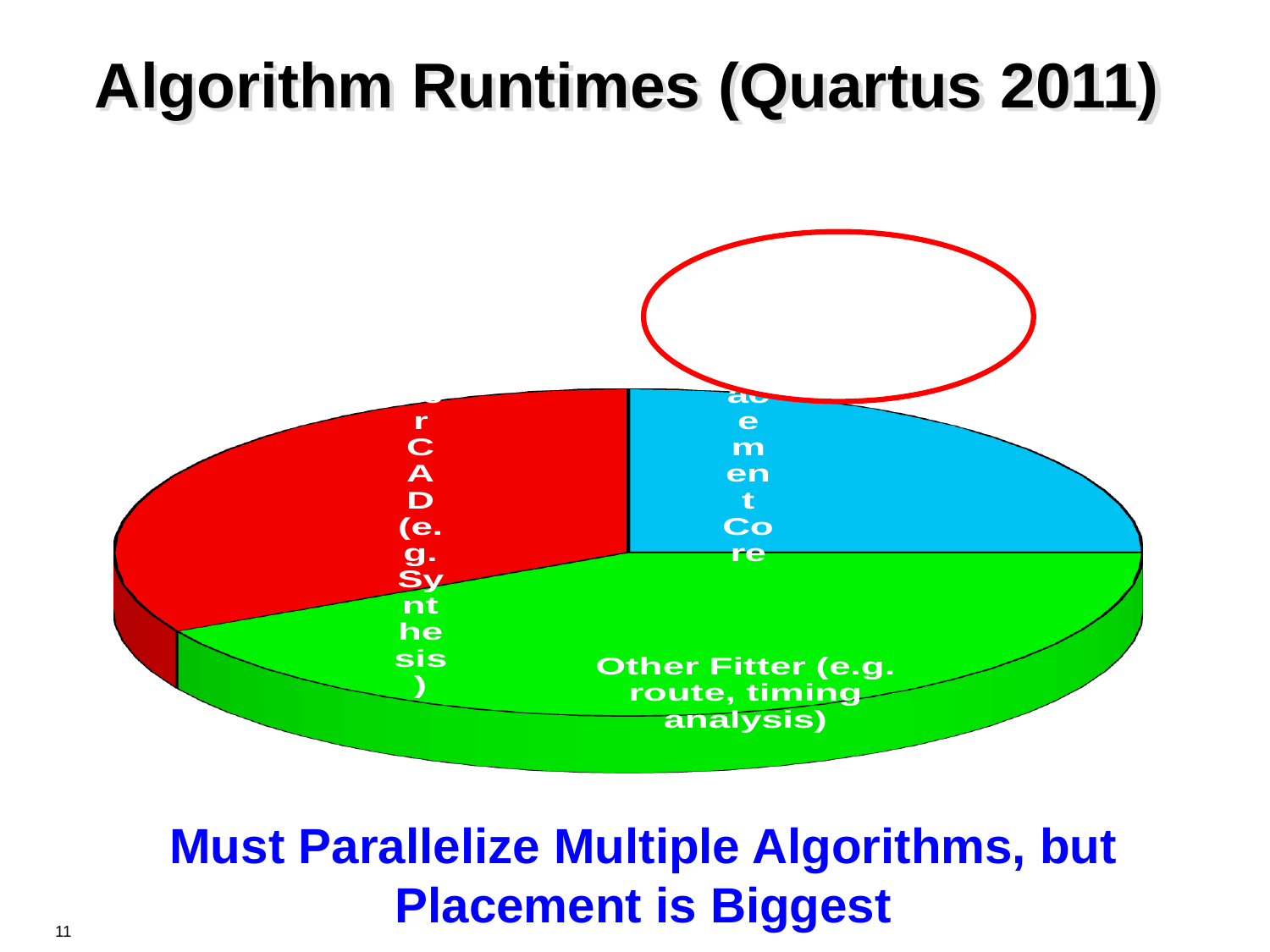
How many slices does the pie chart have? 3 What colour is the Other Fitter (e.g. route, timing analysis) slice? green Which slice is larger: Other Fitter (e.g. route, timing analysis) or Other CAD (e.g. Synthesis)? Other Fitter (e.g. route, timing analysis) What kind of chart is shown on the slide? pie chart What is the title of the chart on the slide? Algorithm Runtimes (Quartus 2011) Which slice of the pie chart is the largest? Other Fitter (e.g. route, timing analysis) Which slice is larger: Other Fitter (e.g. route, timing analysis) or Placement Core? Other Fitter (e.g. route, timing analysis)